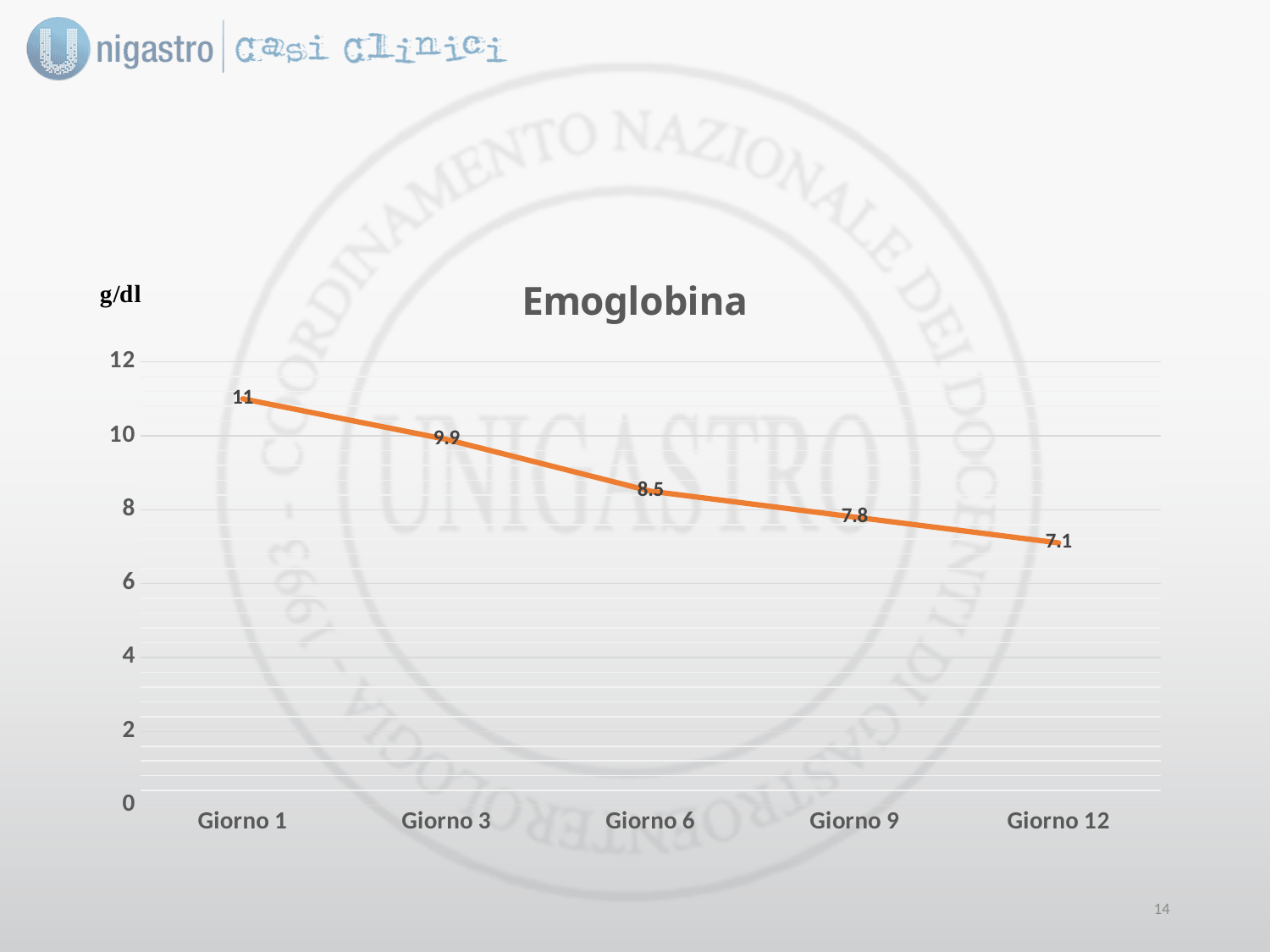
Is the value for Giorno 9 greater or less than 8? less Which day has the lowest value? Giorno 12 Which is larger, the value for Giorno 3 or the value for Giorno 9? Giorno 3 What is the title of the chart? Emoglobina What type of chart is shown on the slide? line chart Do the values rise or fall from Giorno 1 to Giorno 12? fall What is the value for Giorno 1? 11 What is the value for Giorno 6? 8.5 How many data points are plotted on the chart? 5 What is the difference between the values for Giorno 1 and Giorno 12? 3.9 Which day has the highest value? Giorno 1 What is the value for Giorno 12? 7.1